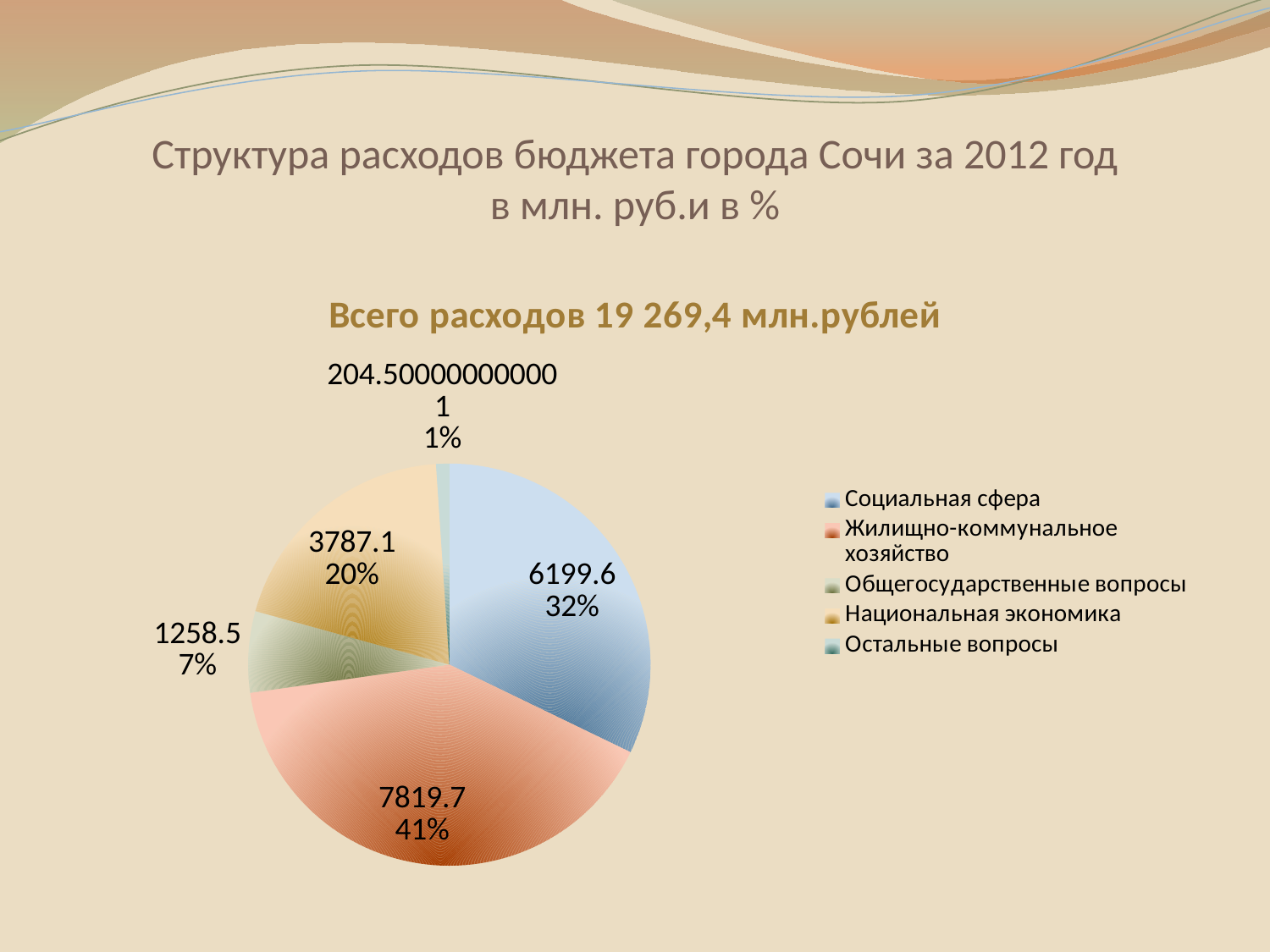
Which is larger, Национальная экономика or Общегосударственные вопросы? Национальная экономика What is the value for Социальная сфера? 6199.6 What share of the pie does Социальная сфера take? 32% What is the difference between the values for Жилищно-коммунальное хозяйство and Социальная сфера? 1620.1 Which category has the largest slice? Жилищно-коммунальное хозяйство What share of the pie does Остальные вопросы take? 1% What is the value for Общегосударственные вопросы? 1258.5 How many categories does the legend list? 5 Which category has the smallest slice? Остальные вопросы What is the value for Жилищно-коммунальное хозяйство? 7819.7 What kind of chart is shown on the slide? pie chart What is the value for Национальная экономика? 3787.1